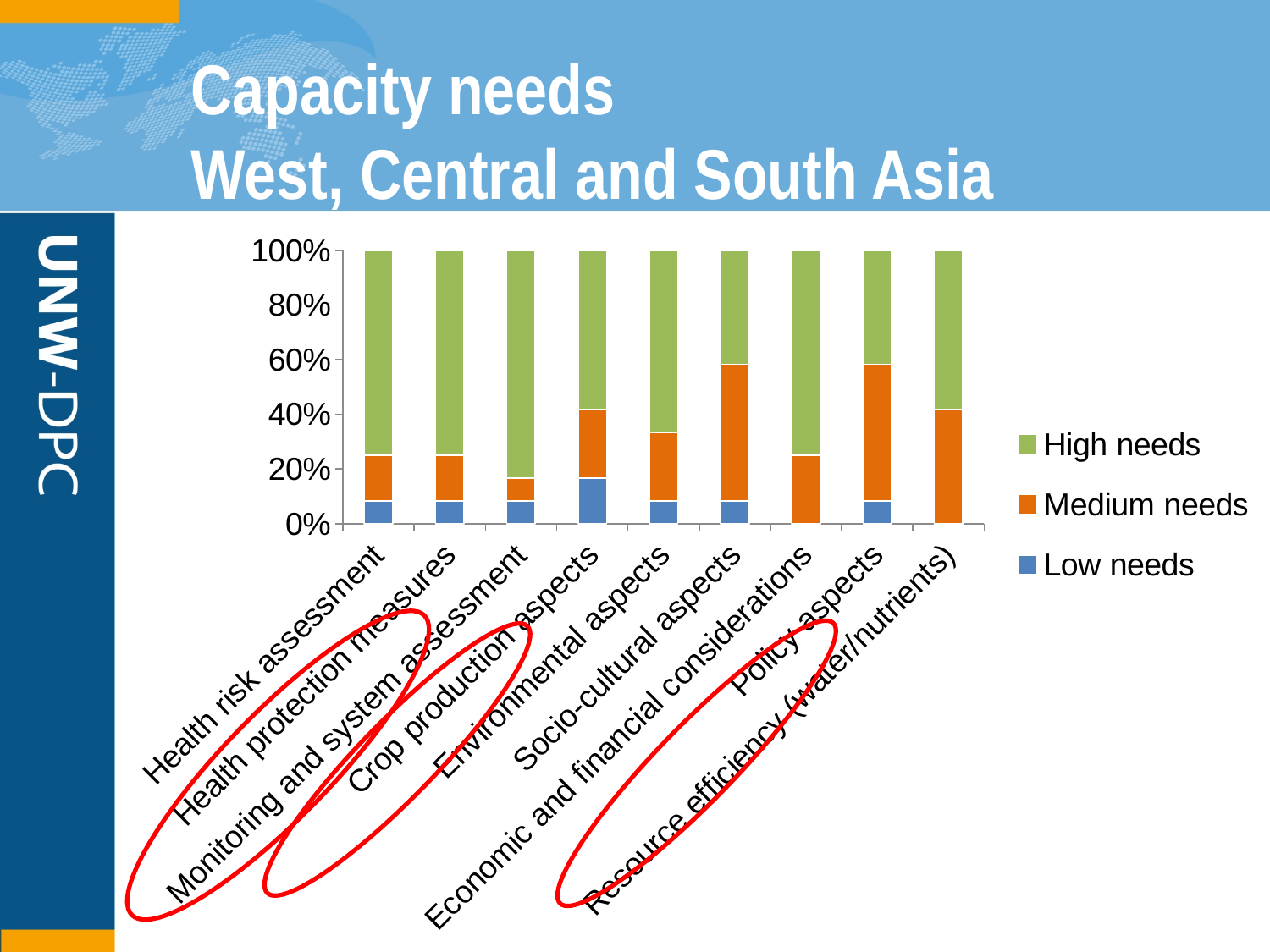
How many series does the chart legend list? 3 What is the total height of each stacked bar in the chart? 100% How many categories have no visible Low needs segment? 2 Is the top of the Medium needs segment for Monitoring and system assessment greater or less than 20%? less Is the High needs segment larger for Health risk assessment or for Socio-cultural aspects? Health risk assessment Which category has the largest High needs segment? Monitoring and system assessment What are the three series listed in the chart legend? High needs, Medium needs, Low needs What kind of chart is shown on the slide? Stacked bar chart Which category has the largest Low needs segment? Crop production aspects How many categories are shown along the x axis of the chart? 9 What is the title of the slide containing the chart? Capacity needs West, Central and South Asia Is the top of the Medium needs segment for Socio-cultural aspects greater or less than 40%? greater